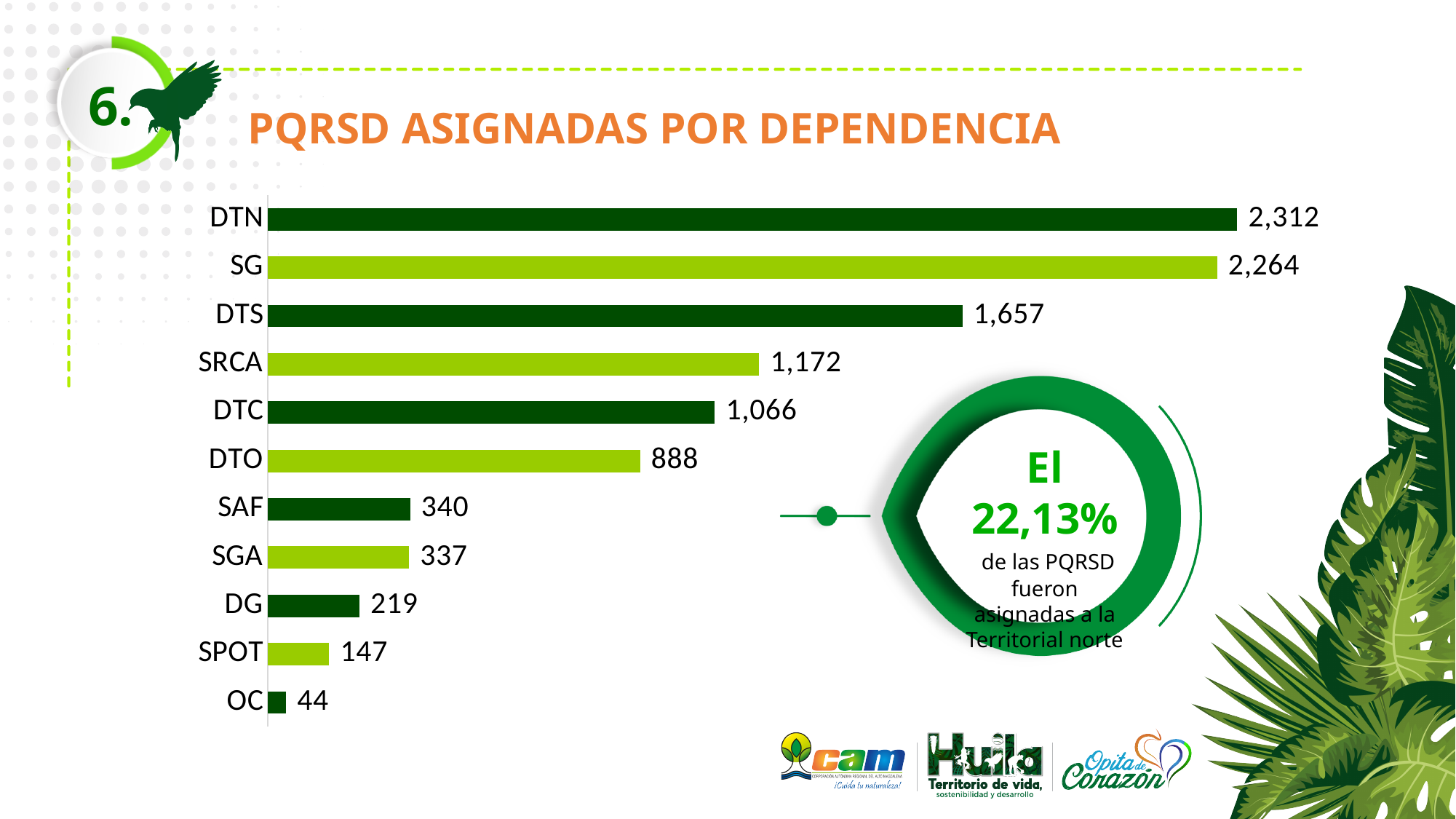
Which is larger, the value for SAF or the value for SGA? SAF Which is larger, the value for DTO or the value for DG? DTO What is the title of the chart? PQRSD ASIGNADAS POR DEPENDENCIA What is the difference between the values for DTS and DTC? 591 What kind of chart is shown on the slide? Bar chart What is the difference between the values for DTN and SG? 48 What is the value for SRCA? 1,172 Which dependencia has the lowest value? OC Which dependencia has the highest value? DTN What is the value for SPOT? 147 What is the value for DTN? 2,312 How many dependencias are shown in the chart? 11